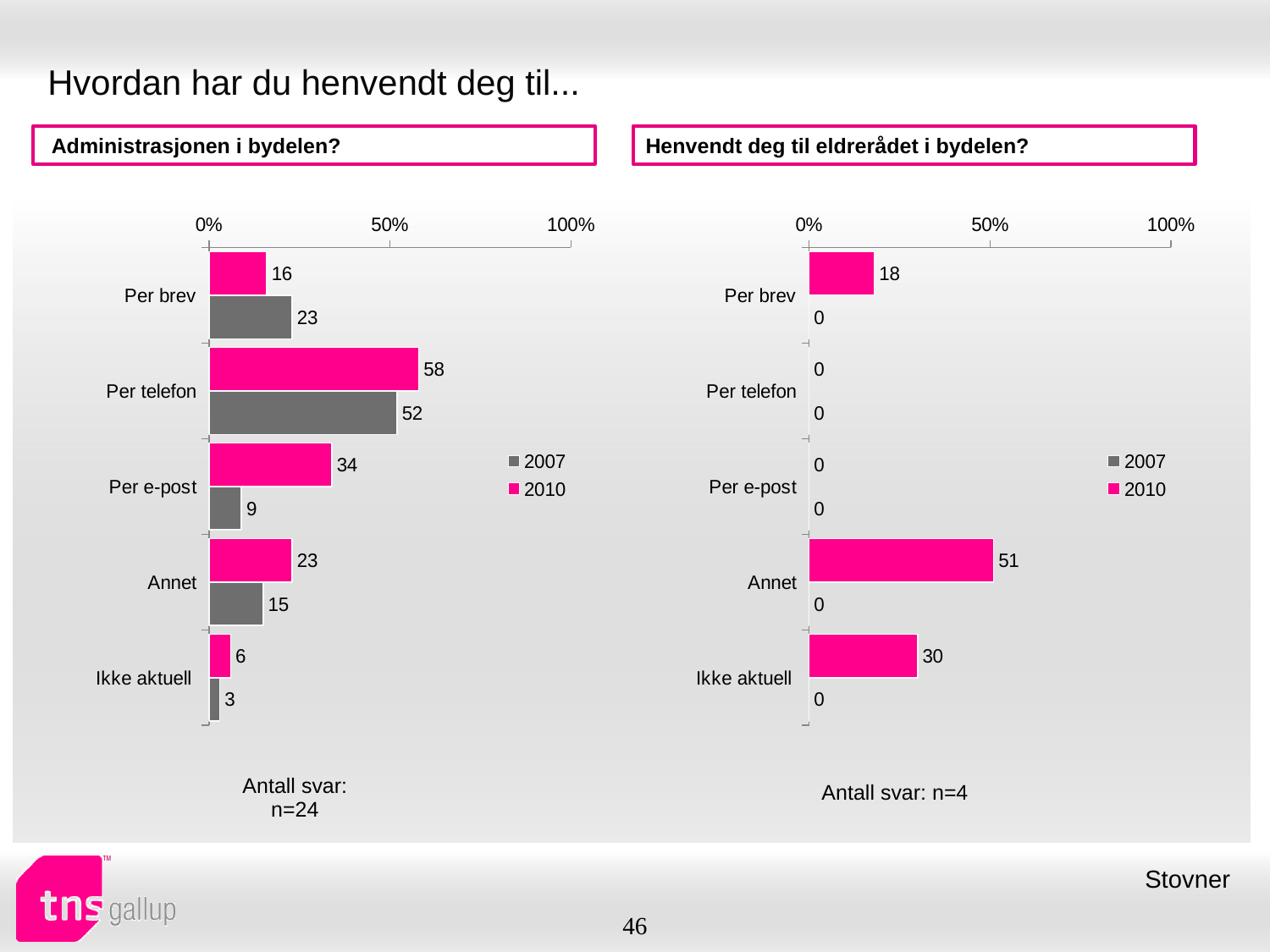
In the 'Administrasjonen i bydelen?' chart, which category has the highest value for 2007? Per telefon In the 'Henvendt deg til eldrerådet i bydelen?' chart, which category has the highest value for 2010? Annet In the 'Administrasjonen i bydelen?' chart, what is the value for Per e-post in 2007? 9 In the 'Henvendt deg til eldrerådet i bydelen?' chart, what is the value for Annet in 2010? 51 In the 'Administrasjonen i bydelen?' chart, which category has the lowest value for 2010? Ikke aktuell In the 'Administrasjonen i bydelen?' chart, is the 2010 value for Per telefon greater or less than 50%? greater In the 'Administrasjonen i bydelen?' chart, which is larger for Per brev: the 2007 value or the 2010 value? 2007 How many series does the legend of the 'Administrasjonen i bydelen?' chart list? 2 In the 'Administrasjonen i bydelen?' chart, what is the difference between the 2010 and 2007 values for Per e-post? 25 In the 'Henvendt deg til eldrerådet i bydelen?' chart, what is the value for Ikke aktuell in 2010? 30 In the 'Administrasjonen i bydelen?' chart, what is the value for Per telefon in 2010? 58 How many categories are shown in the 'Henvendt deg til eldrerådet i bydelen?' chart? 5